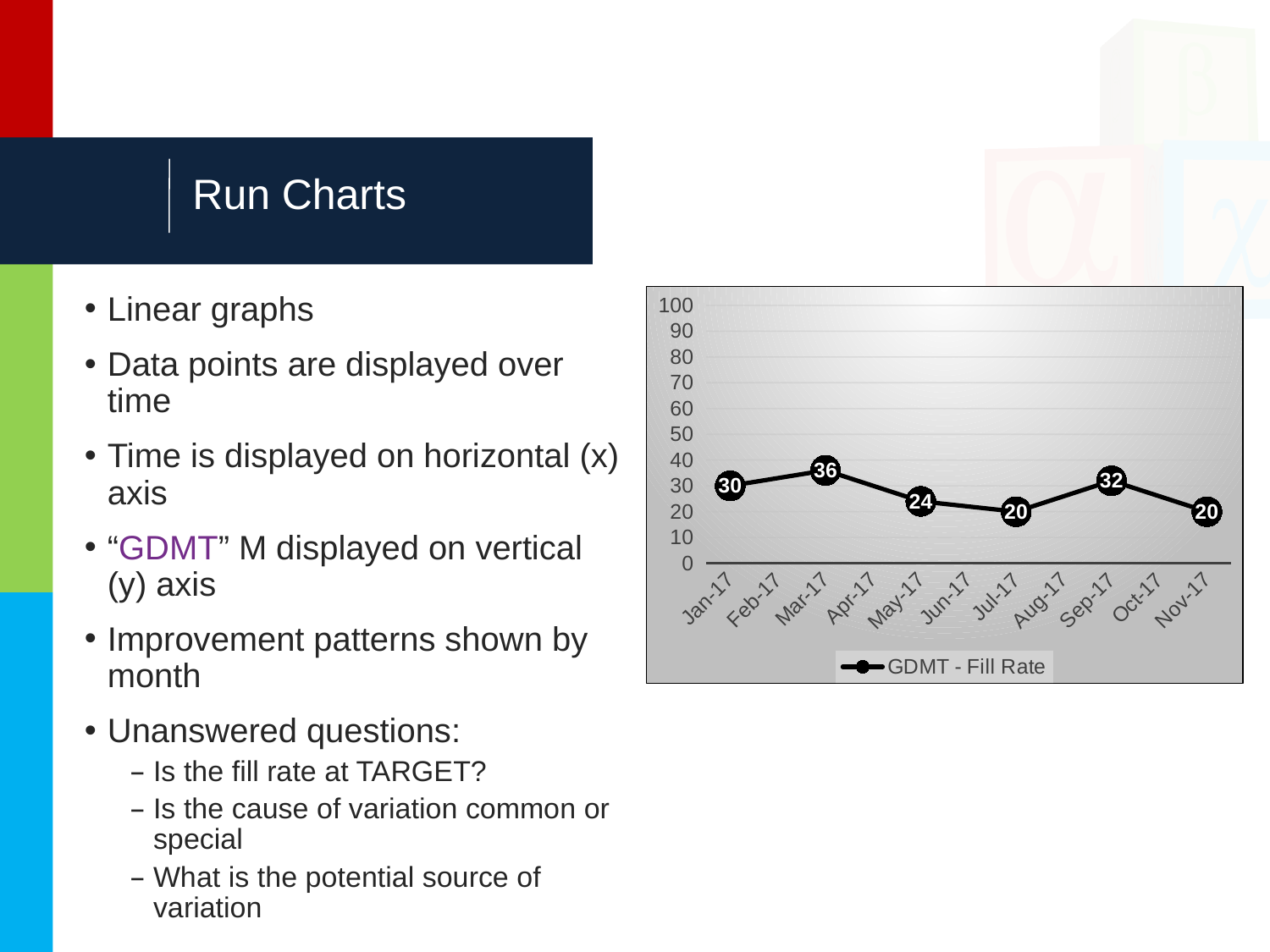
What is the name of the series shown in the legend? GDMT - Fill Rate What type of chart is shown on the slide? line chart What is the GDMT - Fill Rate value for Mar-17? 36 Is the GDMT - Fill Rate value for Sep-17 greater or less than 50? less What is the GDMT - Fill Rate value for Jan-17? 30 How many series does the legend list? 1 Which month has the highest GDMT - Fill Rate value? Mar-17 Which is larger, the GDMT - Fill Rate value for Jan-17 or for May-17? Jan-17 What is the GDMT - Fill Rate value for Sep-17? 32 What is the GDMT - Fill Rate value for May-17? 24 What is the difference between the GDMT - Fill Rate values for Mar-17 and Jul-17? 16 How many data points are plotted on the line? 6